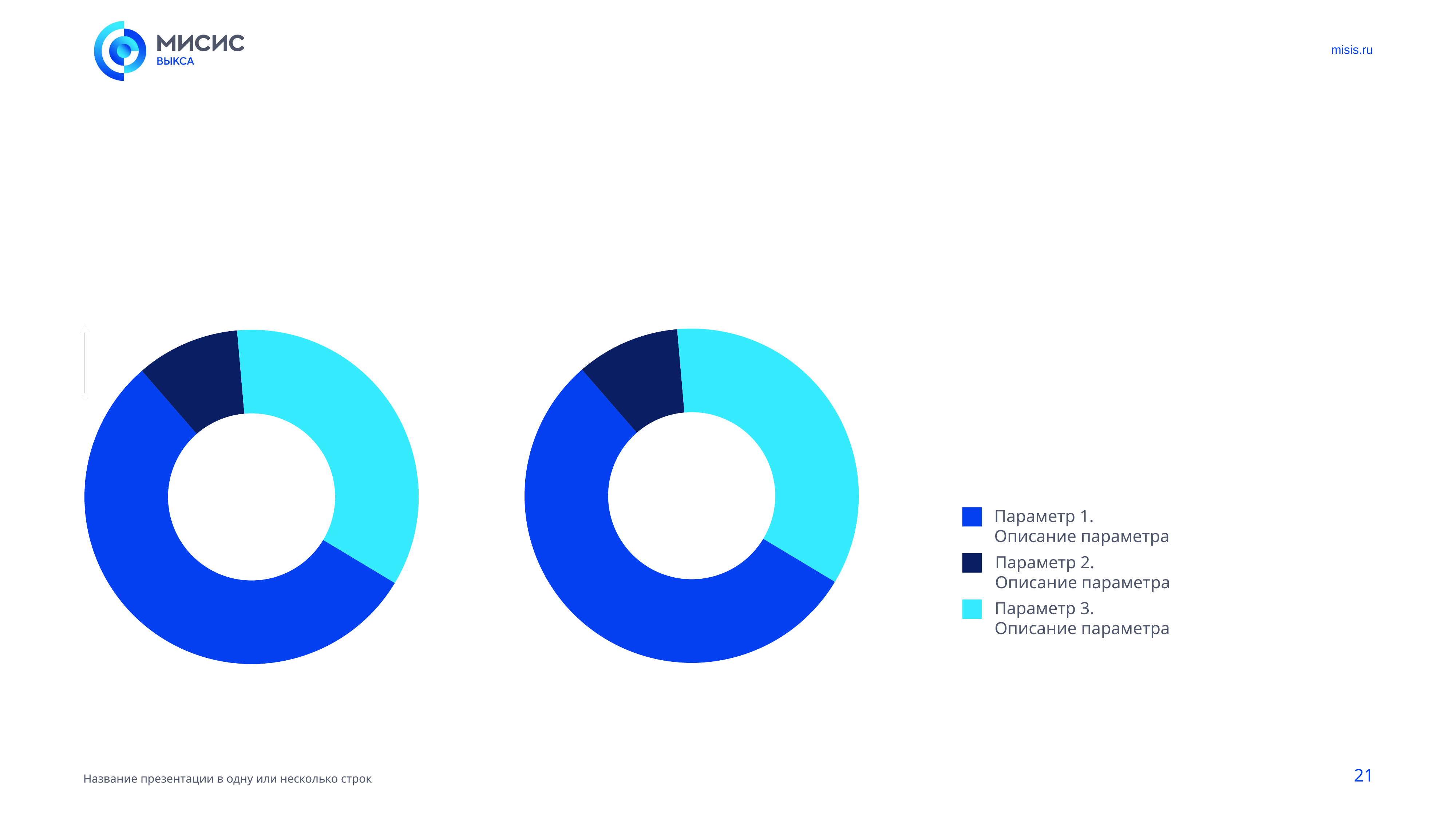
Which colour represents Параметр 2 in the legend? Dark navy blue What kind of chart is the left chart on the slide? Donut (pie) chart What kind of chart is the right chart on the slide? Donut (pie) chart How many slices does the left donut chart have? 3 In the left donut chart, which slice is larger: Параметр 3 or Параметр 2? Параметр 3 How many slices does the right donut chart have? 3 How many entries does the legend list for the charts? 3 In the left donut chart, which parameter has the largest slice? Параметр 1 In the right donut chart, which parameter has the smallest slice? Параметр 2 In the left donut chart, which parameter has the smallest slice? Параметр 2 In the right donut chart, which parameter has the largest slice? Параметр 1 Which colour represents Параметр 3 in the legend? Light cyan